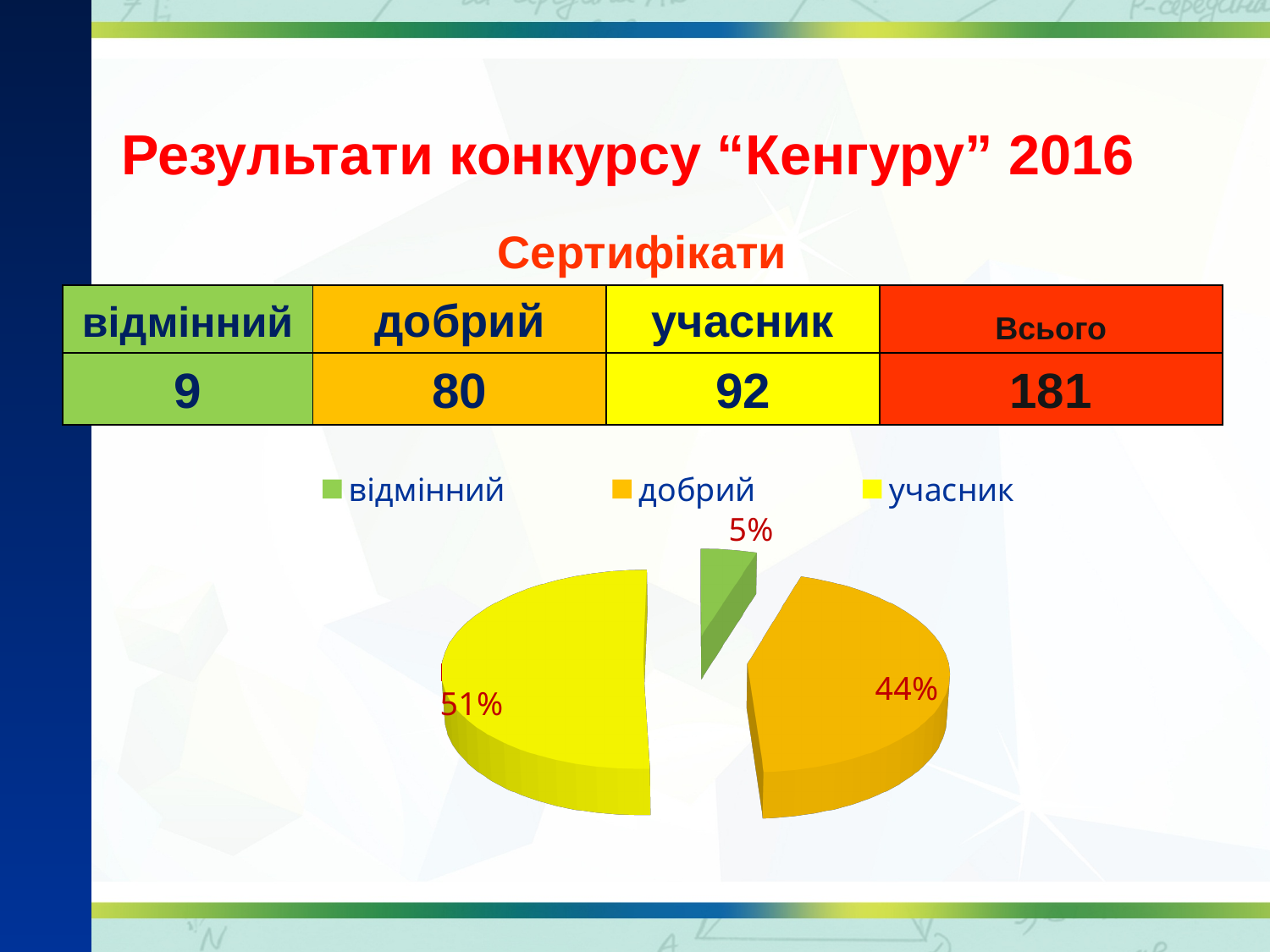
How many entries does the pie chart's legend list? 3 Which legend entry is shown in green in the pie chart? відмінний How many slices does the pie chart have? 3 What share of the pie does the "добрий" slice represent? 44% What share of the pie does the "учасник" slice represent? 51% Which category has the smallest slice in the pie chart? відмінний What share of the pie does the "відмінний" slice represent? 5% Which category has the largest slice in the pie chart? учасник What colour is the "учасник" slice in the pie chart? yellow What kind of chart is shown on the slide? pie chart What is the difference in percentage points between the "учасник" and "добрий" slices? 7% Which slice is larger in the pie chart, "добрий" or "відмінний"? добрий